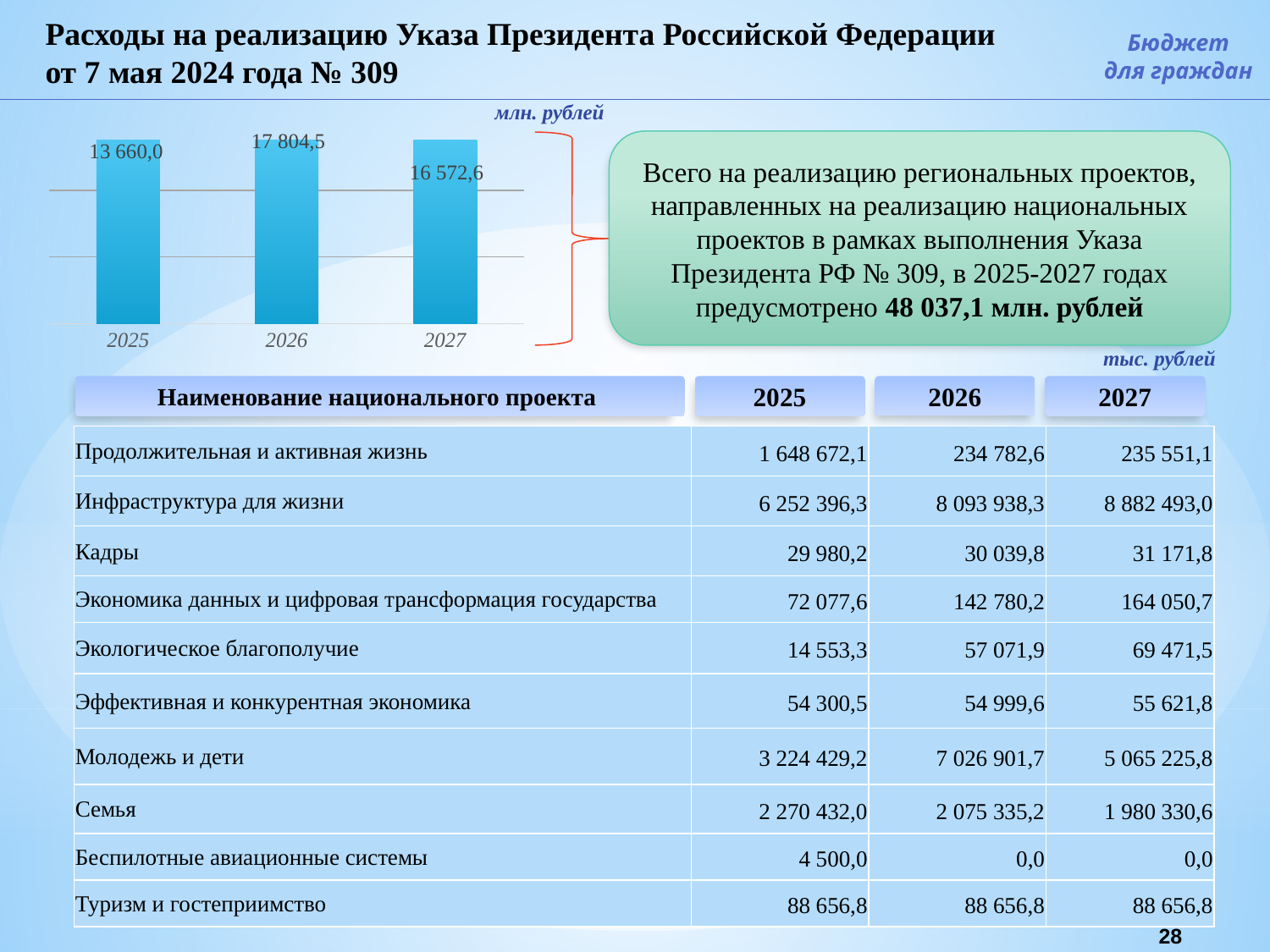
What kind of chart is shown at the top left of the slide? bar chart What is the value of the bar for 2025 in the bar chart? 13 660,0 What unit is indicated above the bar chart? млн. рублей Which year has the highest bar in the bar chart? 2026 What is the value of the bar for 2026 in the bar chart? 17 804,5 What is the value of the bar for 2027 in the bar chart? 16 572,6 What is the difference between the 2026 and 2025 values in the bar chart? 4 144,5 Which year has the lowest bar in the bar chart? 2025 How do the values in the bar chart change from 2025 to 2027? rise then fall How many bars are shown in the bar chart? 3 What is the difference between the 2026 and 2027 values in the bar chart? 1 231,9 Which is larger in the bar chart, the value for 2027 or the value for 2025? 2027